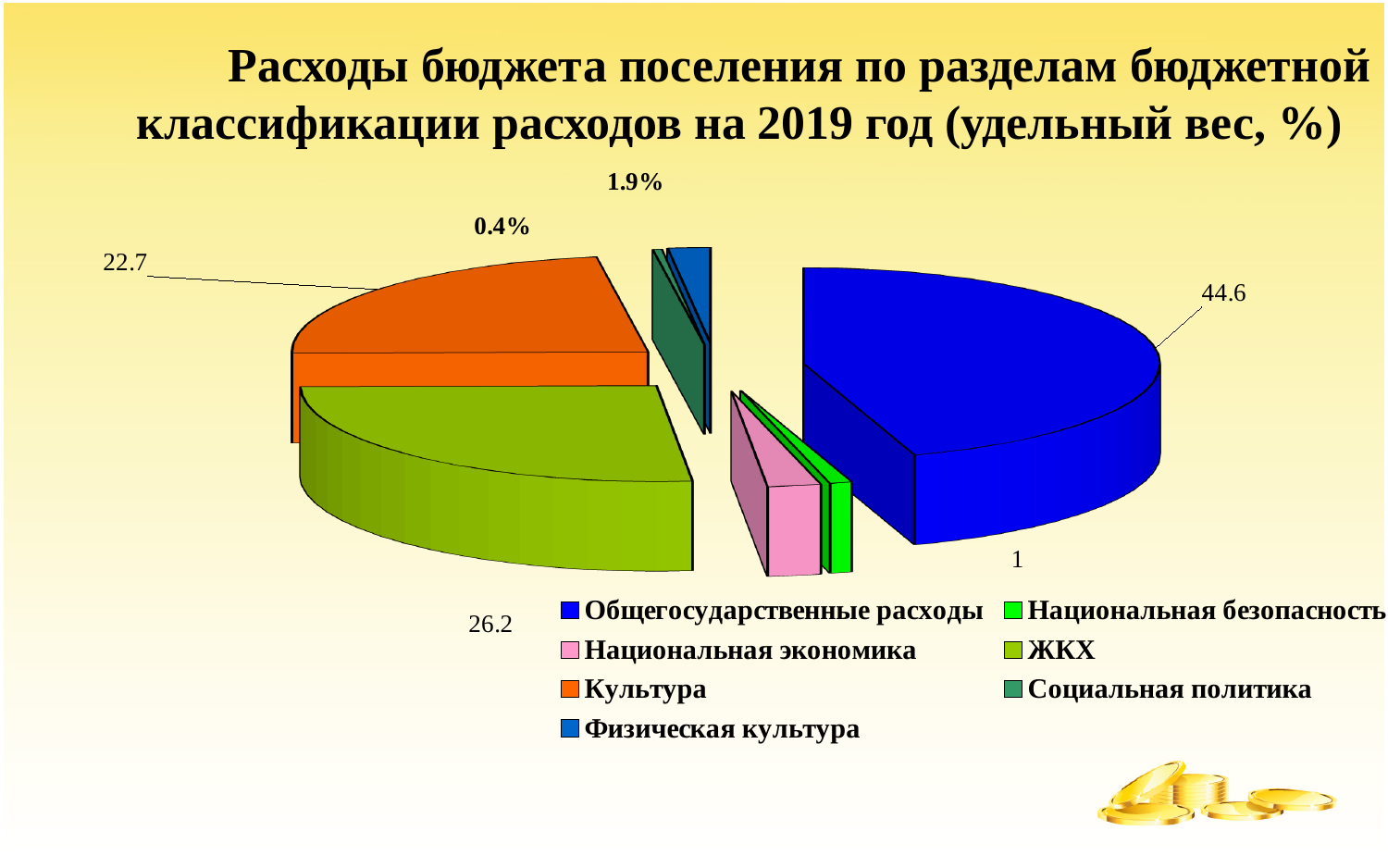
What share of the pie is labelled for Общегосударственные расходы? 44.6 What value is shown for the Культура slice? 22.7 What is the difference between the values for Общегосударственные расходы and Культура? 21.9 What kind of chart is shown on the slide? pie chart What is the difference between the values for ЖКХ and Культура? 3.5 Which slice is larger, Общегосударственные расходы or Культура? Общегосударственные расходы What value is shown for the ЖКХ slice? 26.2 Which slice is larger, Культура or ЖКХ? ЖКХ Which category has the largest slice of the pie? Общегосударственные расходы What colour is the Культура slice in the legend? orange Which year does the chart title refer to? 2019 How many categories does the legend list? 7